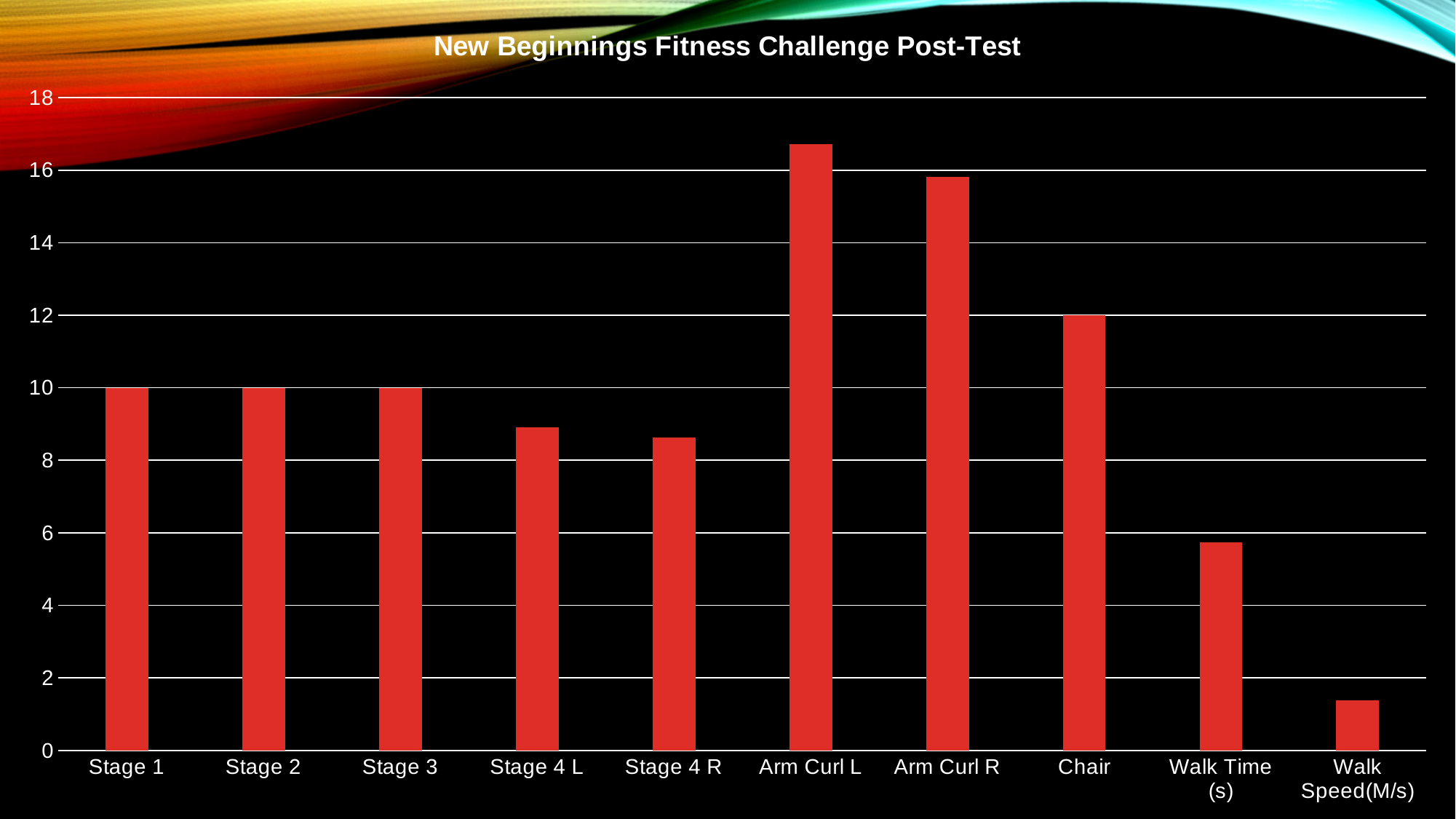
What is the value for Chair? 12 What is the difference between the values for Chair and Stage 2? 2 Is the value for Walk Time (s) greater or less than 6? less Is the value for Stage 4 R greater or less than 8? greater Which category has the lowest value? Walk Speed(M/s) How many categories are plotted on the x axis? 10 Which category has the highest value? Arm Curl L Is the value for Arm Curl L greater or less than 16? greater What type of chart is shown on the slide? bar chart What is the title of the chart? New Beginnings Fitness Challenge Post-Test What is the value for Stage 1? 10 Which is larger, the value for Arm Curl R or the value for Chair? Arm Curl R